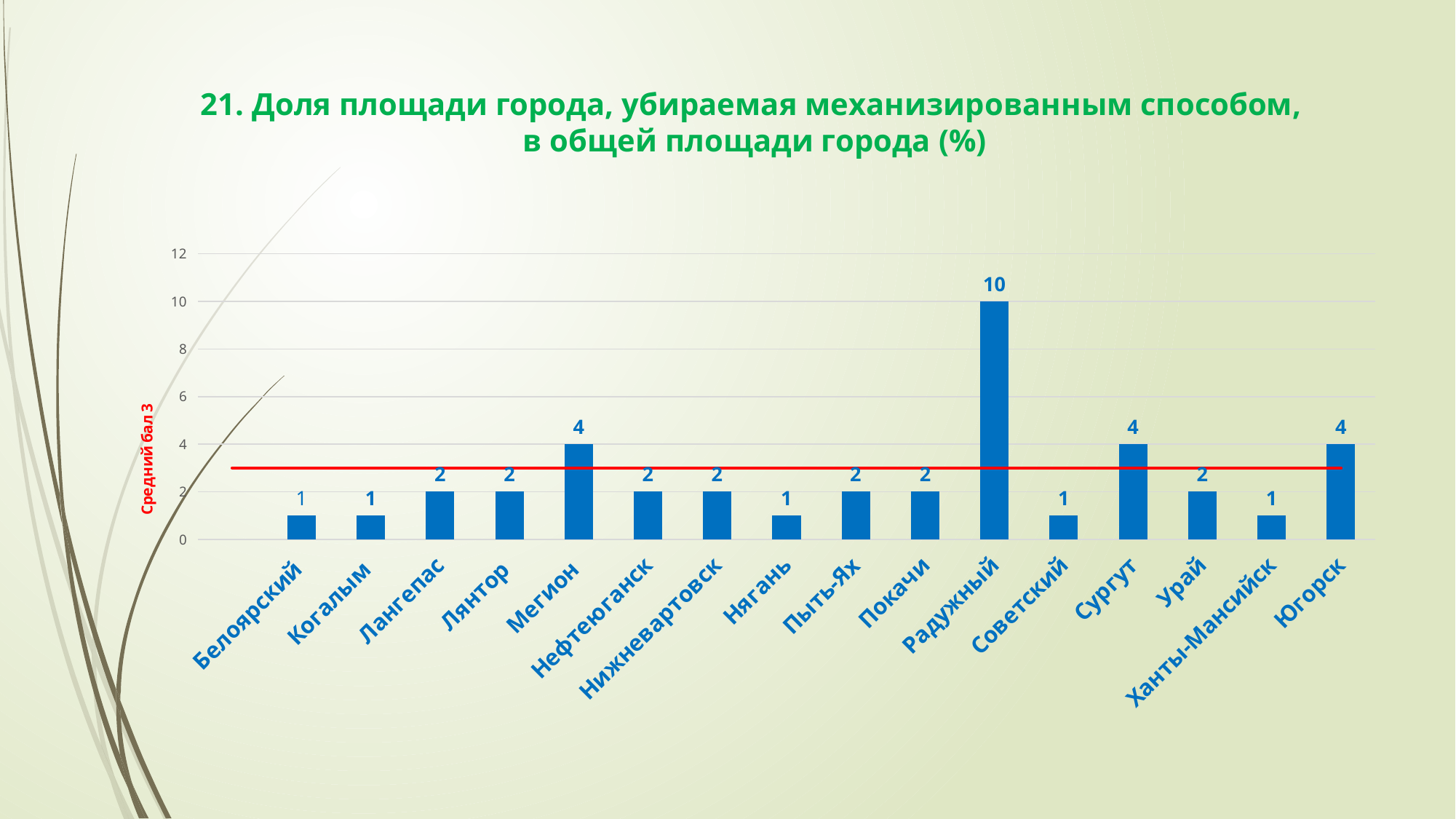
Which is larger, the value for Югорск or the value for Советский? Югорск What is the difference between the values for Радужный and Сургут? 6 Which city has the highest value? Радужный What does the red horizontal line on the chart represent, according to its label? Средний бал 3 What is the value for Мегион? 4 What is the value for Урай? 2 How many cities are shown on the chart? 16 What is the value for Радужный? 10 What is the value for Нягань? 1 What is the lowest value shown on the chart? 1 What kind of chart is shown on the slide? bar chart Is the value for Радужный greater or less than 8? greater